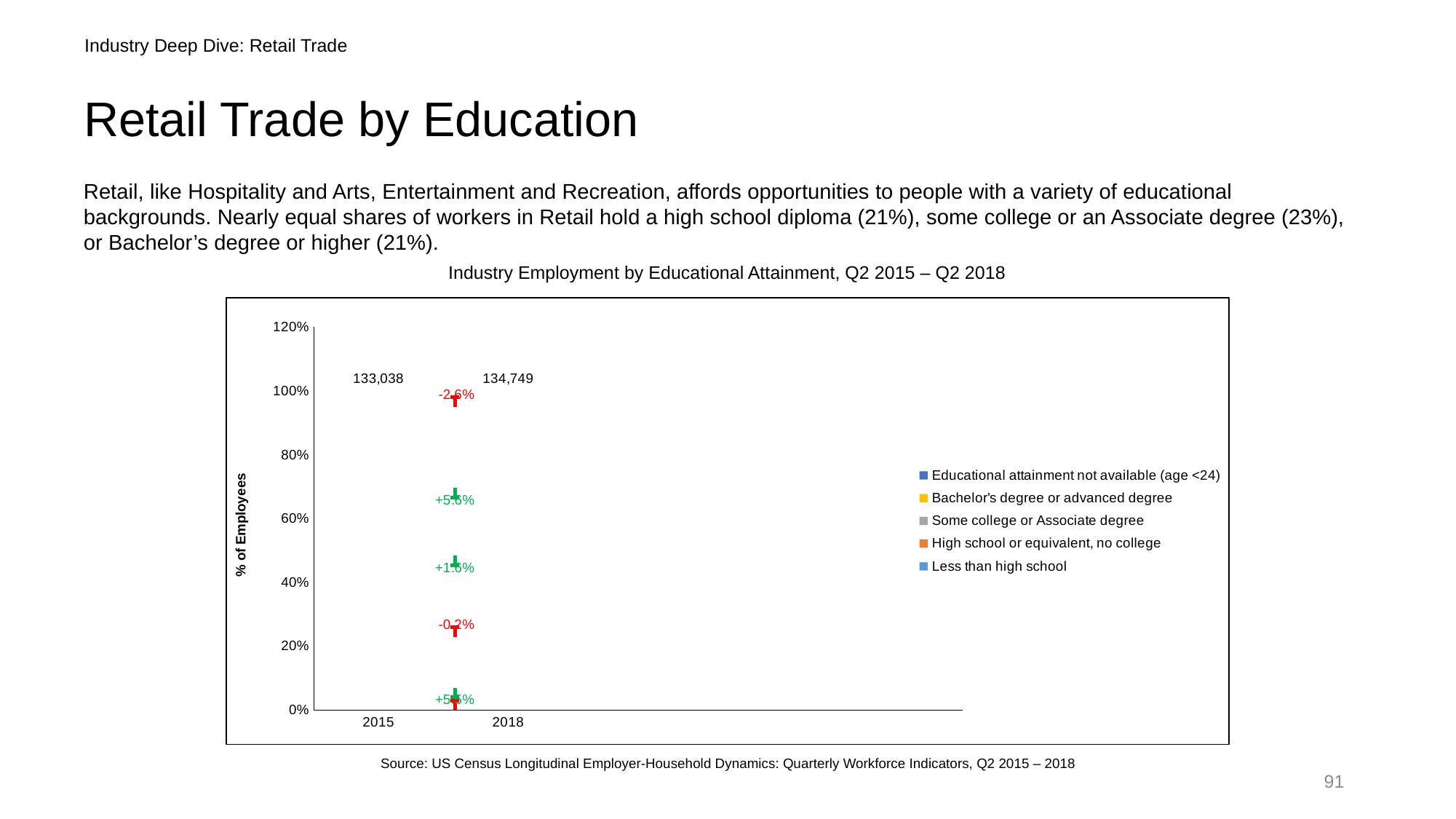
What is the label on the y axis of the chart? % of Employees What total employment figure is labeled above the 2015 bar? 133,038 How many series does the chart's legend list? 5 What is the title of the chart? Industry Employment by Educational Attainment, Q2 2015 – Q2 2018 What is the highest value shown on the y axis of the chart? 120% Which years are shown on the x axis of the chart? 2015 and 2018 Which year has the larger labeled employment total, 2015 or 2018? 2018 What is the difference between the labeled employment totals for 2018 and 2015? 1,711 What total employment figure is labeled above the 2018 bar? 134,749 How many years are shown on the x axis of the chart? 2